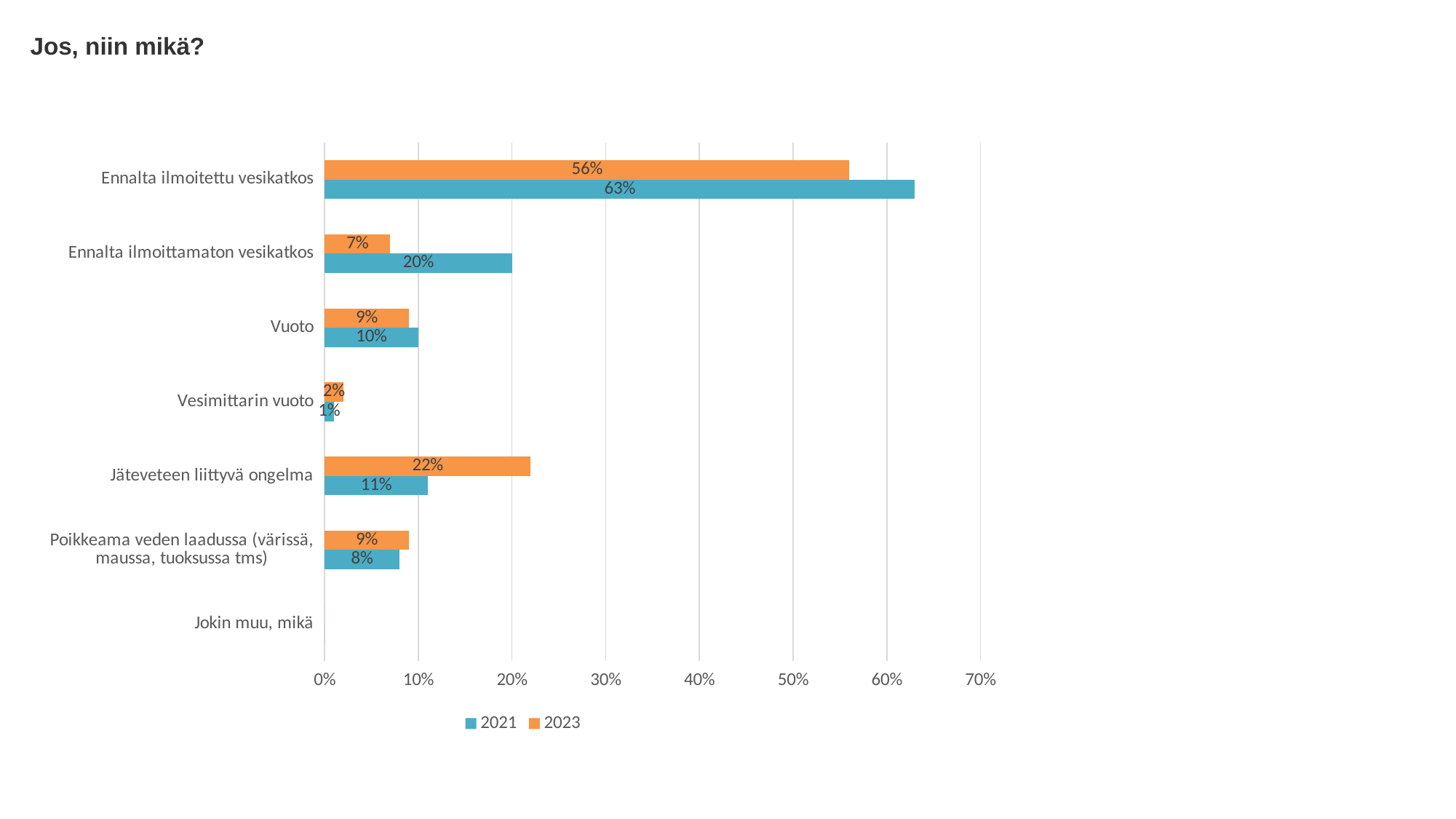
What kind of chart is shown on the slide? bar chart Which category has the highest 2023 value? Ennalta ilmoitettu vesikatkos What is the title of the chart? Jos, niin mikä? What is the 2023 value for Jäteveteen liittyvä ongelma? 22% How many series does the legend list? 2 How many categories are listed on the vertical axis? 7 What is the 2021 value for Poikkeama veden laadussa (värissä, maussa, tuoksussa tms)? 8% What is the 2021 value for Ennalta ilmoitettu vesikatkos? 63% What is the difference between the 2021 and 2023 values for Ennalta ilmoittamaton vesikatkos? 13% For Jäteveteen liittyvä ongelma, which year has the larger value, 2021 or 2023? 2023 What is the 2023 value for Ennalta ilmoittamaton vesikatkos? 7% Which category has the lowest 2021 value among those with a bar? Vesimittarin vuoto